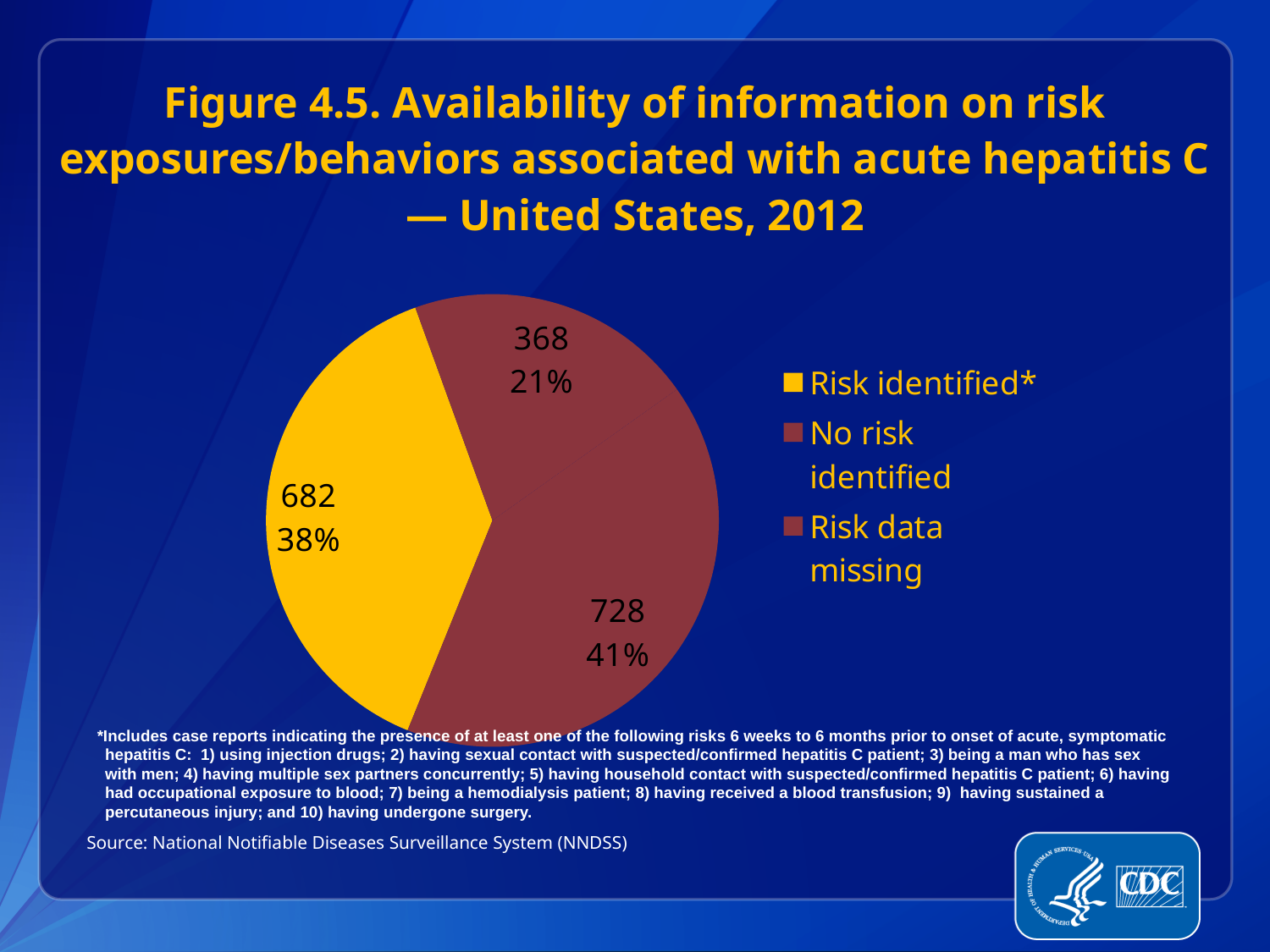
What kind of chart is shown on the slide? pie chart How many cases are shown for the Risk identified* slice? 682 What is the difference between the slice labeled 728 and the Risk identified* slice? 46 How many entries does the legend list? 3 Is the Risk identified* slice larger or smaller than the slice labeled 728? smaller What percentage is shown for the slice labeled 728? 41% What colour is used for the Risk identified* slice? yellow What is the total number of cases across all three slices of the pie? 1778 What count is shown for the slice labeled 21%? 368 What is the difference between the largest slice (728) and the smallest slice (368)? 360 How many slices does the pie chart have? 3 What share of the pie does the Risk identified* slice represent? 38%